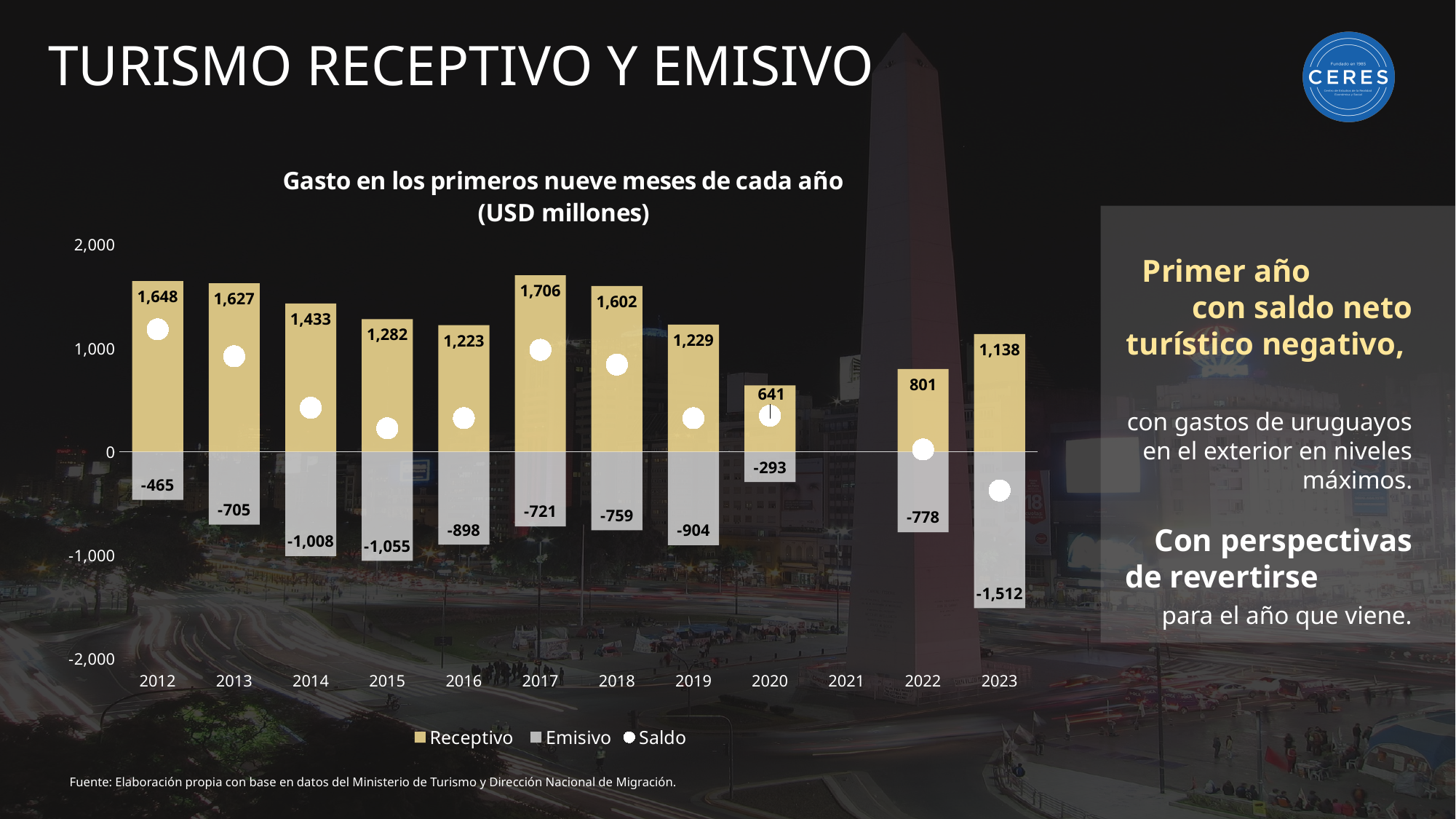
Which is larger, the Receptivo value for 2014 or for 2015? 2014 What is the Emisivo value for 2023? -1,512 Which year has the lowest Receptivo value? 2020 Is the Saldo value for 2023 greater or less than 0? less What kind of chart is shown on the slide? bar chart Which year has the highest Receptivo value? 2017 What is the Receptivo value for 2017? 1,706 Which year has the largest Emisivo spending (most negative bar)? 2023 How many series does the legend list? 3 What is the difference between the Receptivo values for 2017 and 2012? 58 Do the Receptivo values rise or fall from 2017 to 2020? fall What is the Receptivo value for 2020? 641